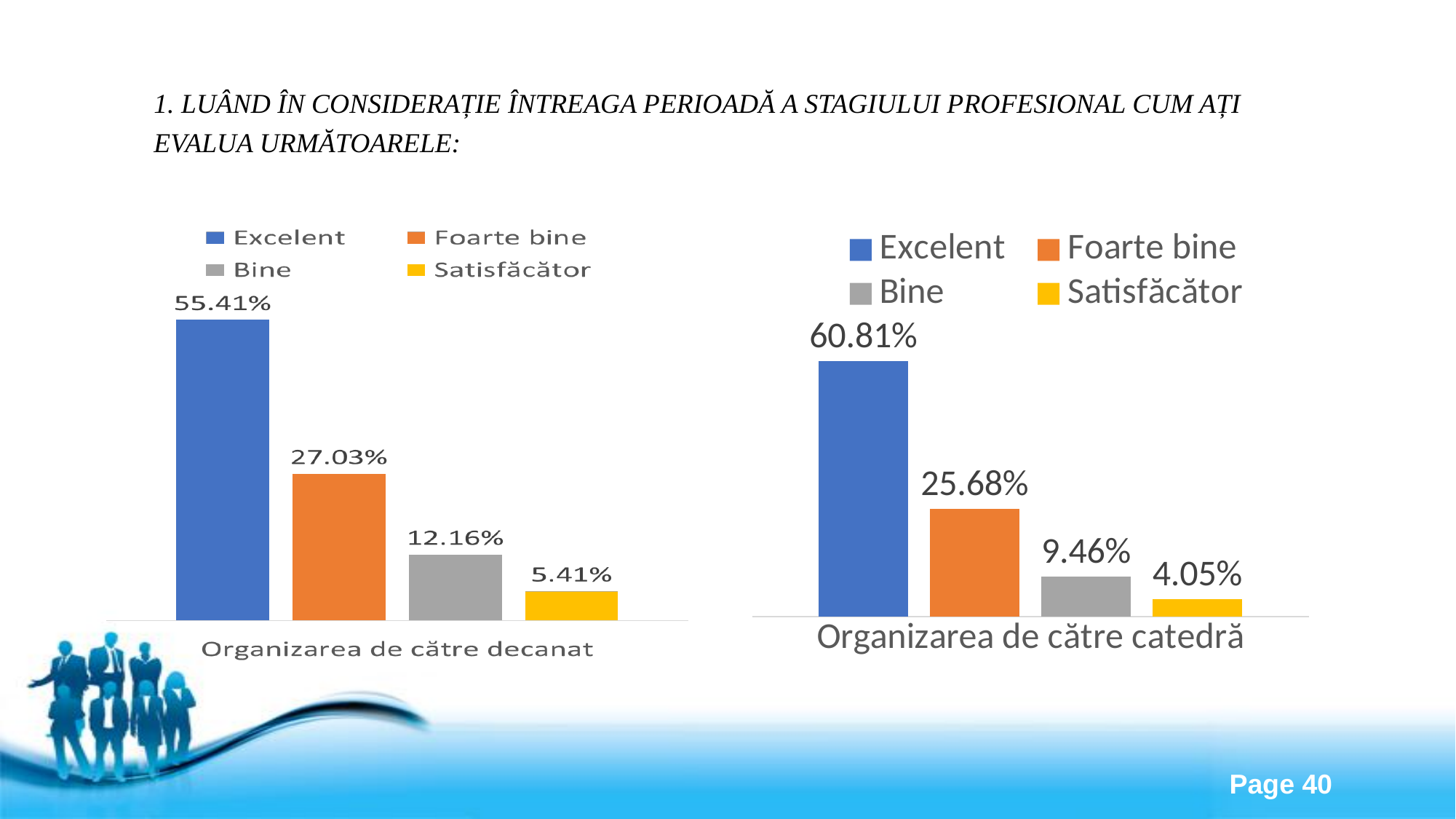
In the left chart (Organizarea de către decanat), what colour is the Bine bar? Grey In the left chart (Organizarea de către decanat), what is the difference between Excelent and Foarte bine? 28.38% Which is larger: Excelent in the left chart (Organizarea de către decanat) or Excelent in the right chart (Organizarea de către catedră)? Excelent in the right chart (Organizarea de către catedră) In the left chart (Organizarea de către decanat), which series has the lowest value? Satisfăcător In the right chart (Organizarea de către catedră), which series has the highest value? Excelent In the right chart (Organizarea de către catedră), what is the difference between Bine and Satisfăcător? 5.41% What kind of chart is the left chart (Organizarea de către decanat)? Bar chart In the left chart (Organizarea de către decanat), what is the value for Excelent? 55.41% In the left chart (Organizarea de către decanat), what is the value for Satisfăcător? 5.41% In the right chart (Organizarea de către catedră), what is the value for Bine? 9.46% How many series does the legend of the right chart (Organizarea de către catedră) list? 4 In the right chart (Organizarea de către catedră), what is the value for Foarte bine? 25.68%